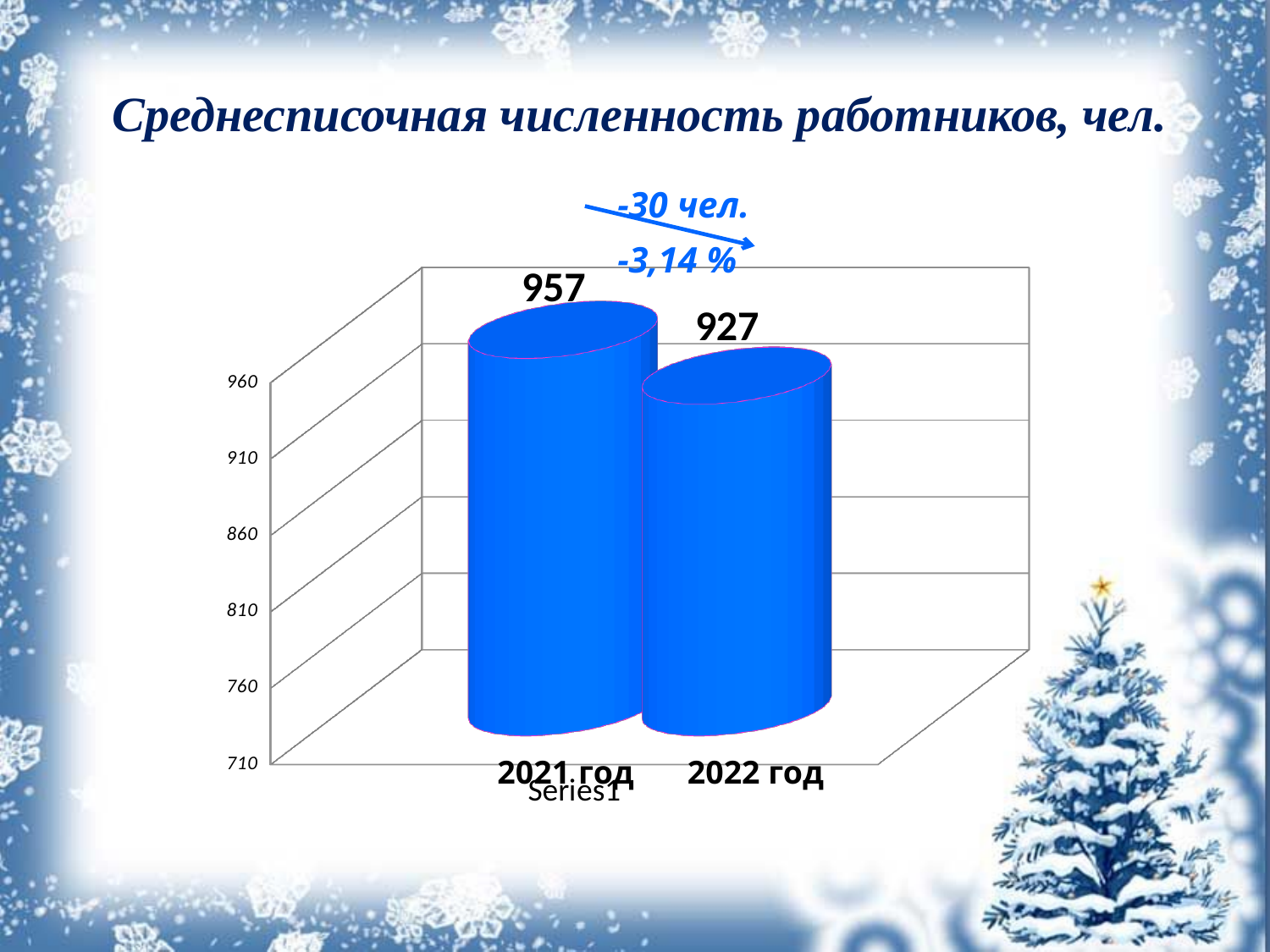
How many categories (years) are shown on the chart? 2 What kind of chart is shown on the slide? bar chart Which year has the higher average headcount? 2021 год What is the title of the chart? Среднесписочная численность работников, чел. What percentage change is annotated on the chart? -3,14 % Is the value for 2022 год greater or less than 910? greater What is the average headcount of employees for 2022 год? 927 What is the average headcount of employees for 2021 год? 957 Which year has the lower average headcount? 2022 год By how much did the average headcount change from 2021 год to 2022 год? 30 Is the value for 2021 год larger or smaller than the value for 2022 год? larger Do the values rise or fall from 2021 год to 2022 год? fall